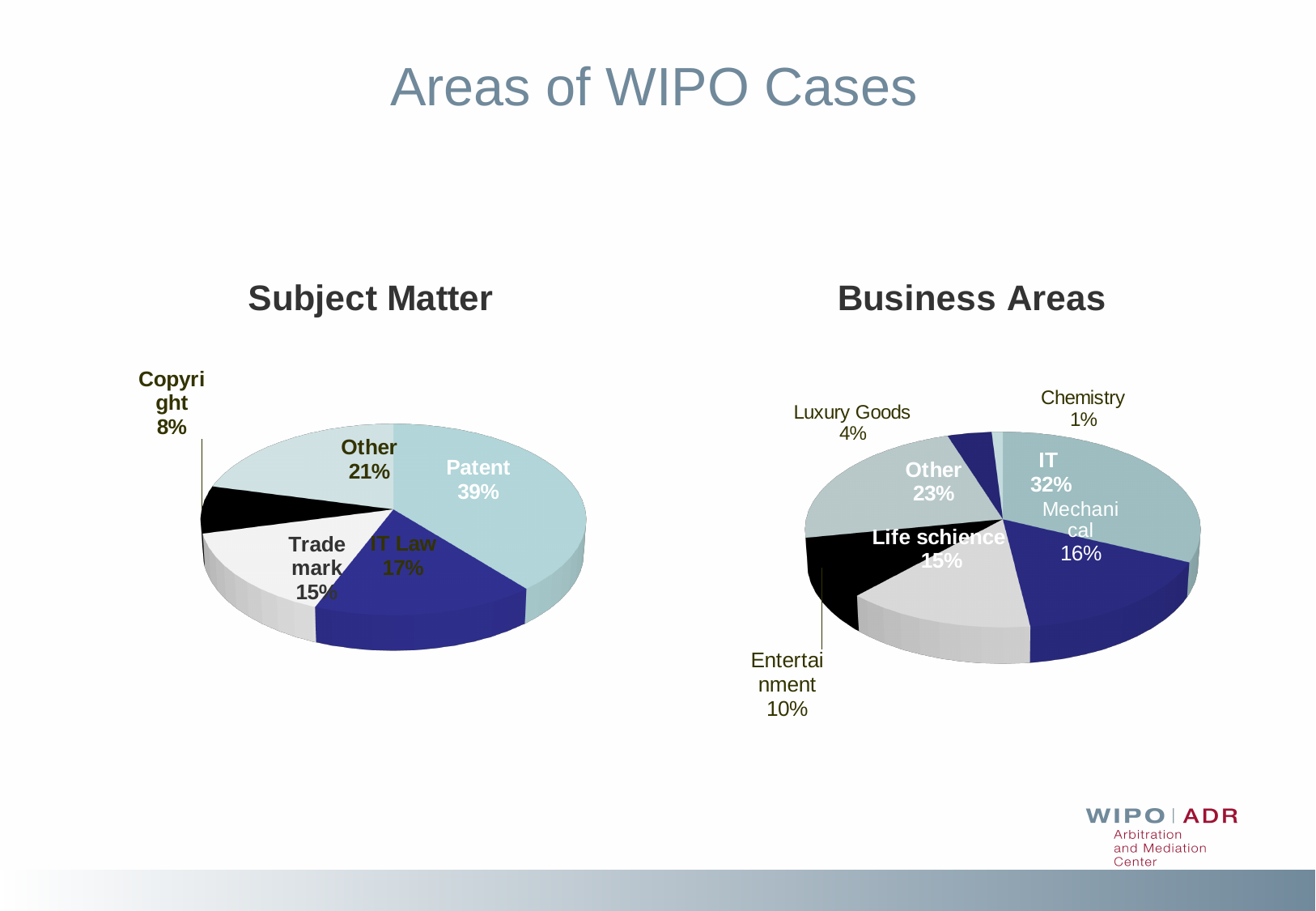
How many categories are shown in the Business Areas chart? 7 In the Subject Matter chart, which category has the largest share? Patent In the Subject Matter chart, what share of cases is Patent? 39% How many categories are shown in the Subject Matter chart? 5 In the Business Areas chart, what share of cases is Chemistry? 1% In the Business Areas chart, which category has the smallest share? Chemistry In the Business Areas chart, what share of cases is IT? 32% What type of chart is the Business Areas chart? Pie chart In the Subject Matter chart, what share of cases is Copyright? 8% In the Business Areas chart, which is larger, Mechanical or Entertainment? Mechanical In the Subject Matter chart, what is the difference between the Patent share and the IT Law share? 22% In the Subject Matter chart, which category has the smallest share? Copyright